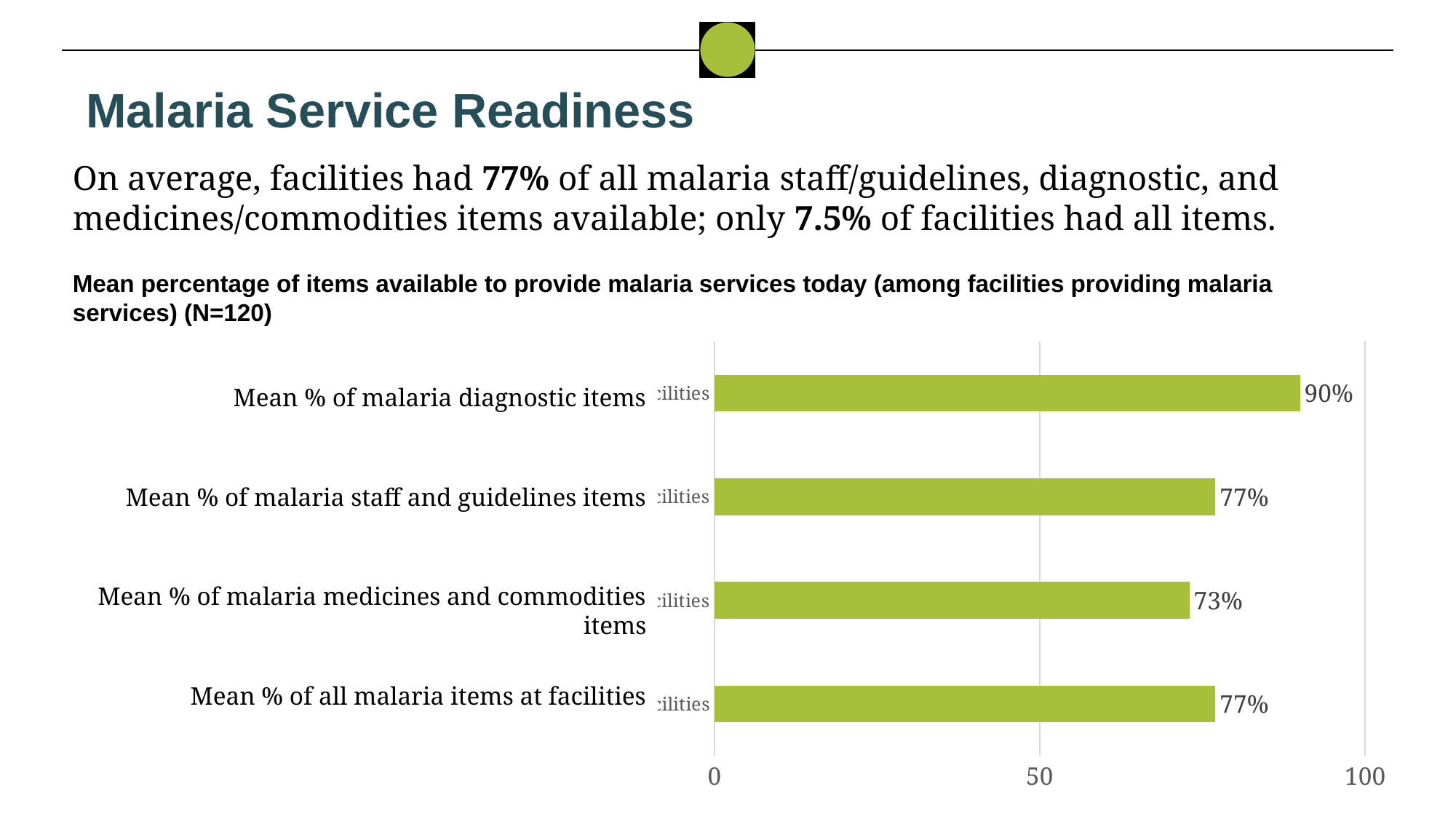
Which category has the lowest mean percentage of items available? Mean % of malaria medicines and commodities items What is the mean % of all malaria items at facilities? 77% What is the mean % of malaria diagnostic items available? 90% What kind of chart is shown on the slide? Bar chart How many categories are shown in the chart? 4 What is the sample size (N) stated in the chart title? 120 What is the difference between the mean % of malaria diagnostic items and the mean % of malaria medicines and commodities items? 17% Is the value for mean % of malaria medicines and commodities items greater or less than 50? greater What is the mean % of malaria staff and guidelines items available? 77% What is the mean % of malaria medicines and commodities items available? 73% Which category has the highest mean percentage of items available? Mean % of malaria diagnostic items Which is larger: the mean % of malaria diagnostic items or the mean % of malaria staff and guidelines items? Mean % of malaria diagnostic items